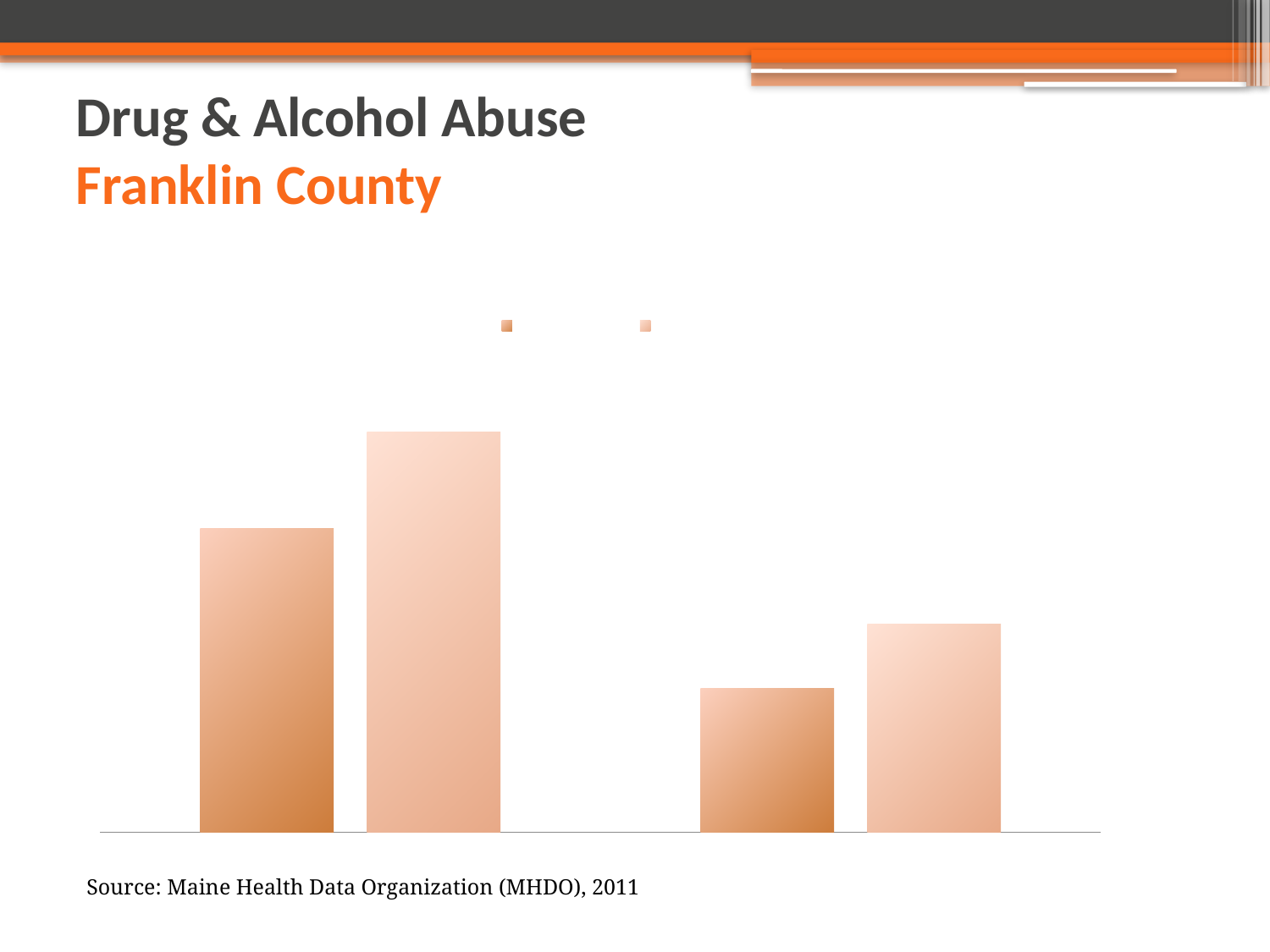
What kind of chart is shown on the slide? bar chart Do the bar heights rise or fall from the left group to the right group? fall Which group of bars, left or right, contains the tallest bar in the chart? left What is the title text shown above the chart on the slide? Drug & Alcohol Abuse Franklin County In the left group of bars, is the lighter bar taller or shorter than the darker bar? taller How many groups of bars are plotted along the x axis? 2 How many bars are plotted in the chart? 4 What source is cited below the chart? Maine Health Data Organization (MHDO), 2011 Which group of bars, left or right, contains the shortest bar in the chart? right How many series does the legend list? 2 In the right group of bars, is the lighter bar taller or shorter than the darker bar? taller